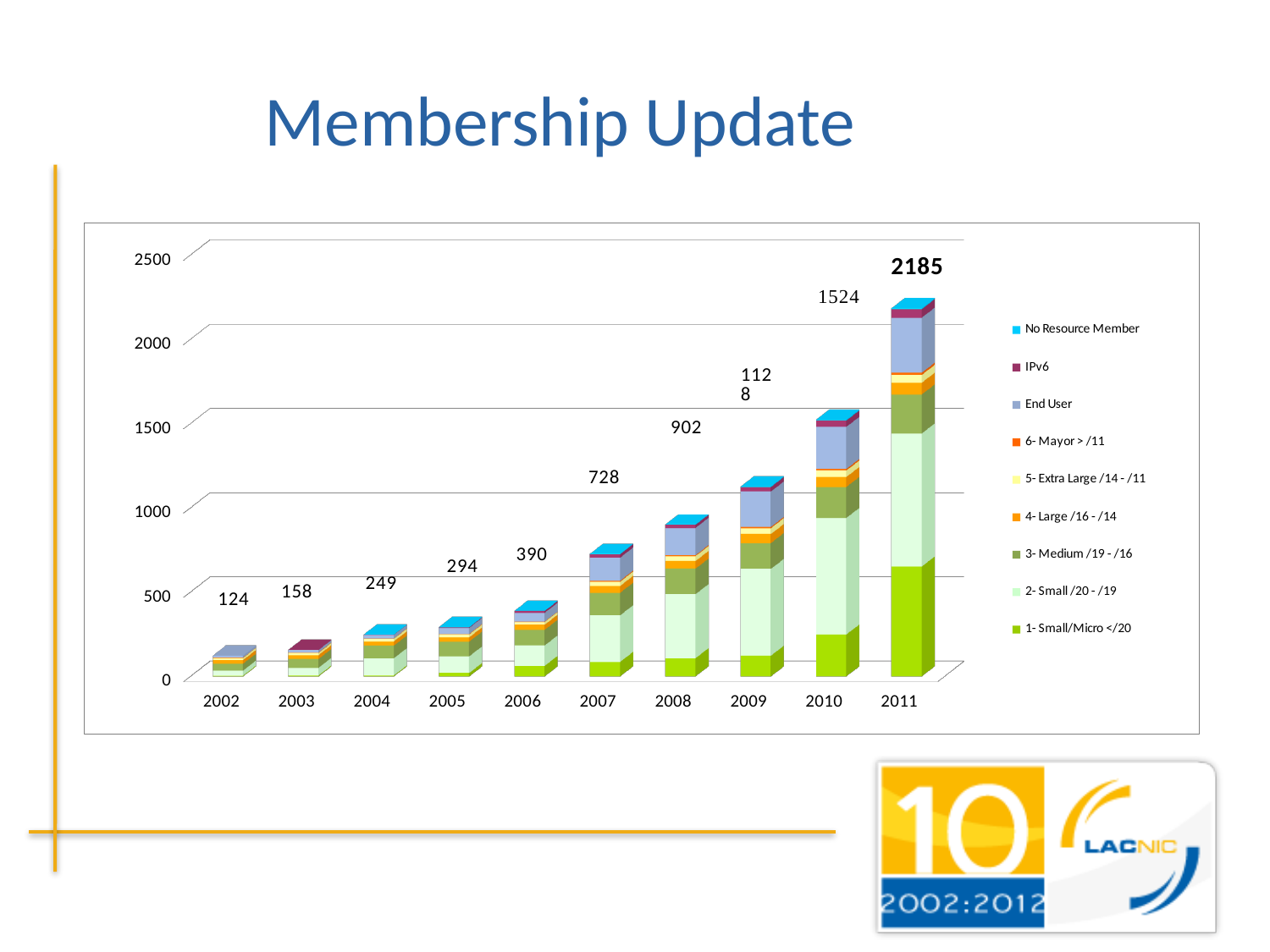
How many series does the legend list? 9 What kind of chart is shown on the slide? Stacked bar chart What is the total membership shown for 2007? 728 Which year has a larger total membership, 2005 or 2006? 2006 How many years are shown on the x axis? 10 What is the difference between the total membership in 2011 and in 2010? 661 What is the difference between the total membership in 2008 and in 2007? 174 Which year has the highest total membership? 2011 Which year has the lowest total membership? 2002 What is the total membership shown for 2002? 124 What is the total membership shown for 2011? 2185 Is the total membership for 2010 greater or less than 1500? greater